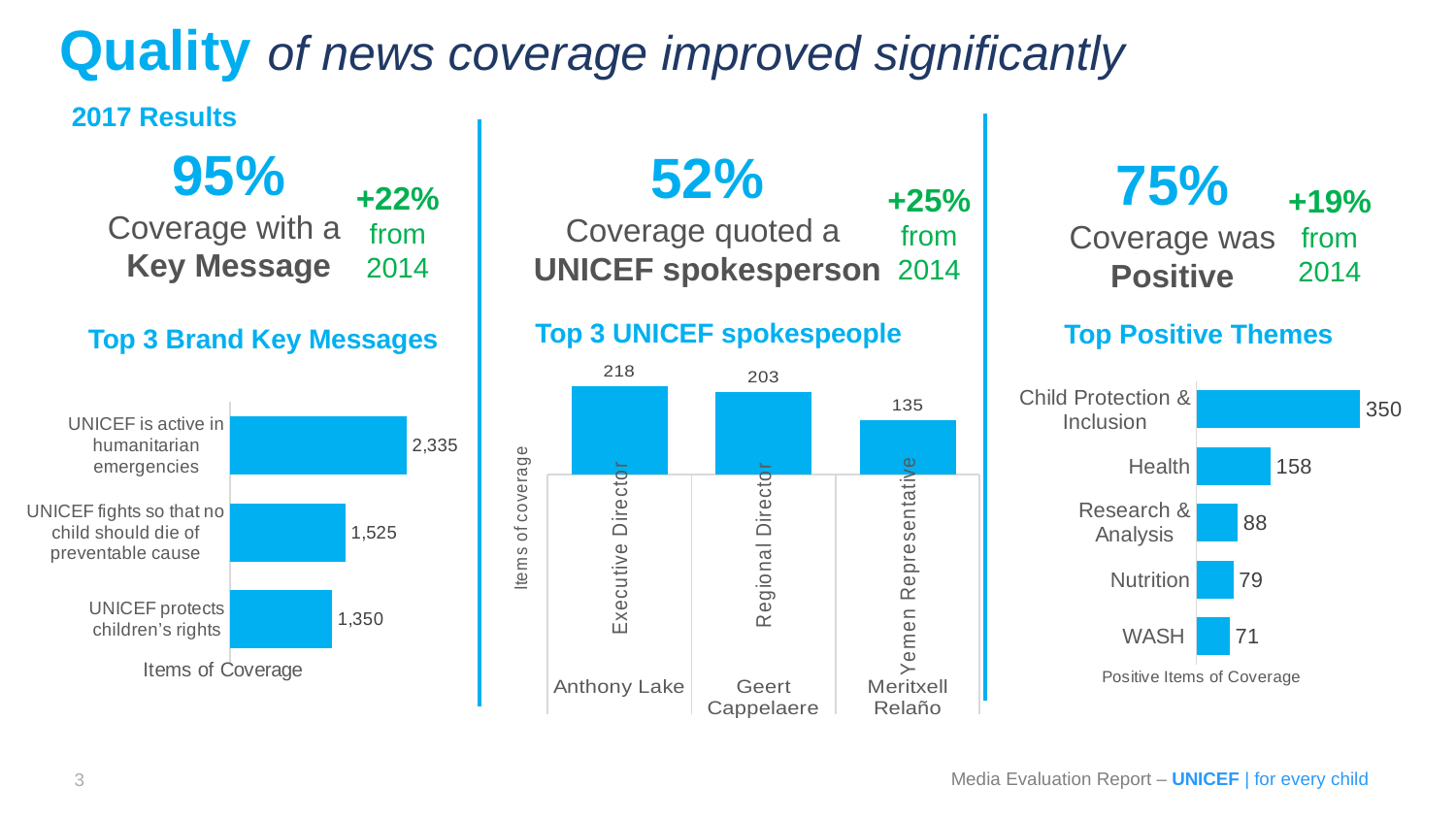
In the 'Top 3 Brand Key Messages' chart, what is the difference between 'UNICEF is active in humanitarian emergencies' and 'UNICEF fights so that no child should die of preventable cause'? 810 In the 'Top Positive Themes' chart, how many themes are shown? 5 In the 'Top Positive Themes' chart, what is the total of Research & Analysis and Nutrition? 167 In the 'Top 3 Brand Key Messages' chart, which key message has the lowest number of items of coverage? UNICEF protects children's rights What type of chart is the 'Top 3 UNICEF spokespeople' chart? Bar chart In the 'Top Positive Themes' chart, how many positive items of coverage does Health have? 158 In the 'Top 3 Brand Key Messages' chart, how many items of coverage does 'UNICEF is active in humanitarian emergencies' have? 2,335 In the 'Top 3 UNICEF spokespeople' chart, how many items of coverage does Anthony Lake have? 218 In the 'Top Positive Themes' chart, which is larger, Nutrition or WASH? Nutrition In the 'Top Positive Themes' chart, which theme has the highest number of positive items of coverage? Child Protection & Inclusion In the 'Top 3 UNICEF spokespeople' chart, what is the difference between Geert Cappelaere and Meritxell Relaño? 68 In the 'Top 3 UNICEF spokespeople' chart, which spokesperson has the fewest items of coverage? Meritxell Relaño